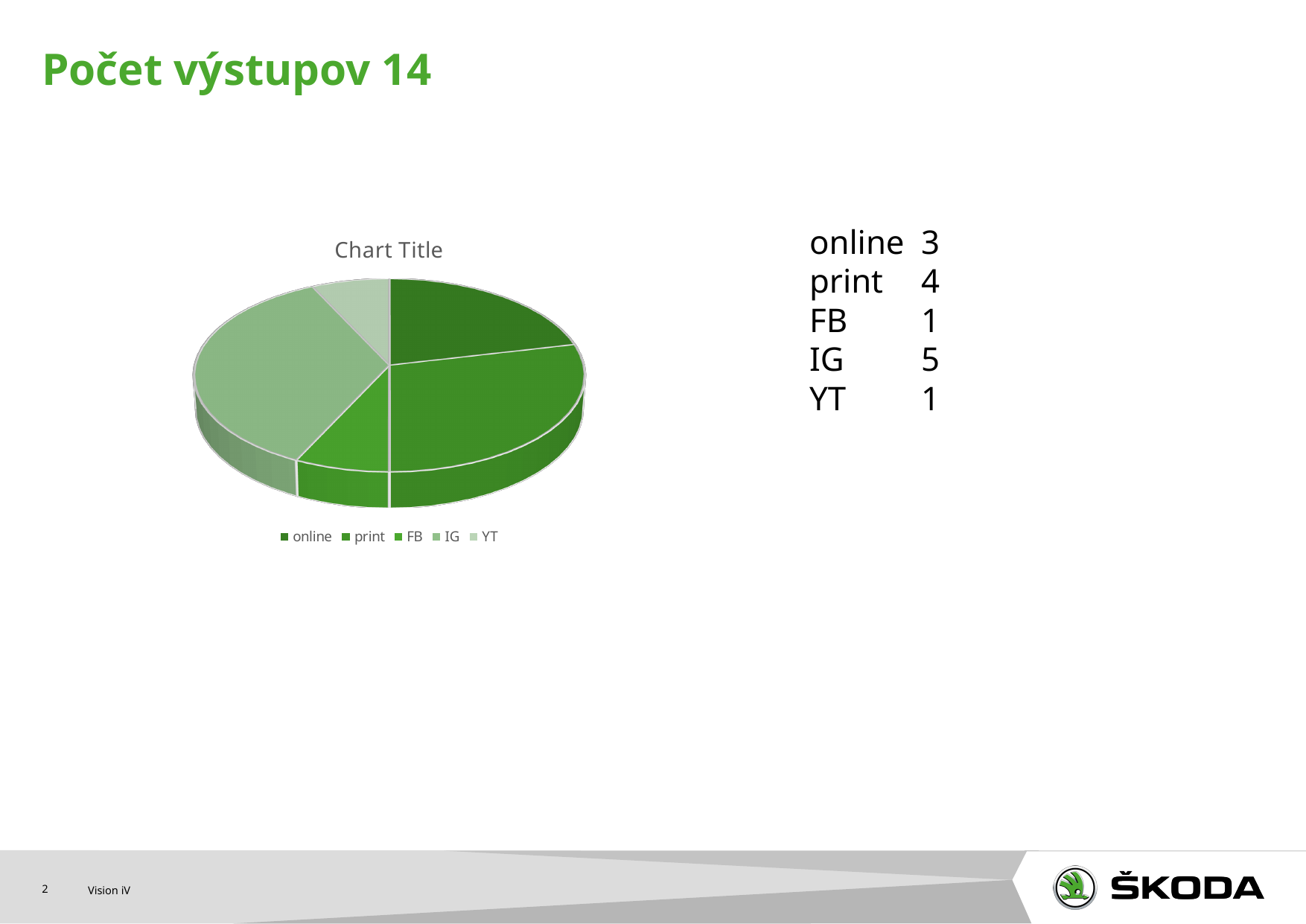
Which category is listed last in the legend? YT How many categories does the pie chart have? 5 What type of chart is shown on the slide? pie chart Which is larger, the value for IG or the value for online? IG What is the value for IG? 5 What is the total of all the values in the pie chart? 14 What is the value for print? 4 What is the value for online? 3 What is the difference between the value for IG and the value for FB? 4 What is the title shown above the pie chart? Chart Title What is the value for FB? 1 Which category has the largest slice of the pie? IG